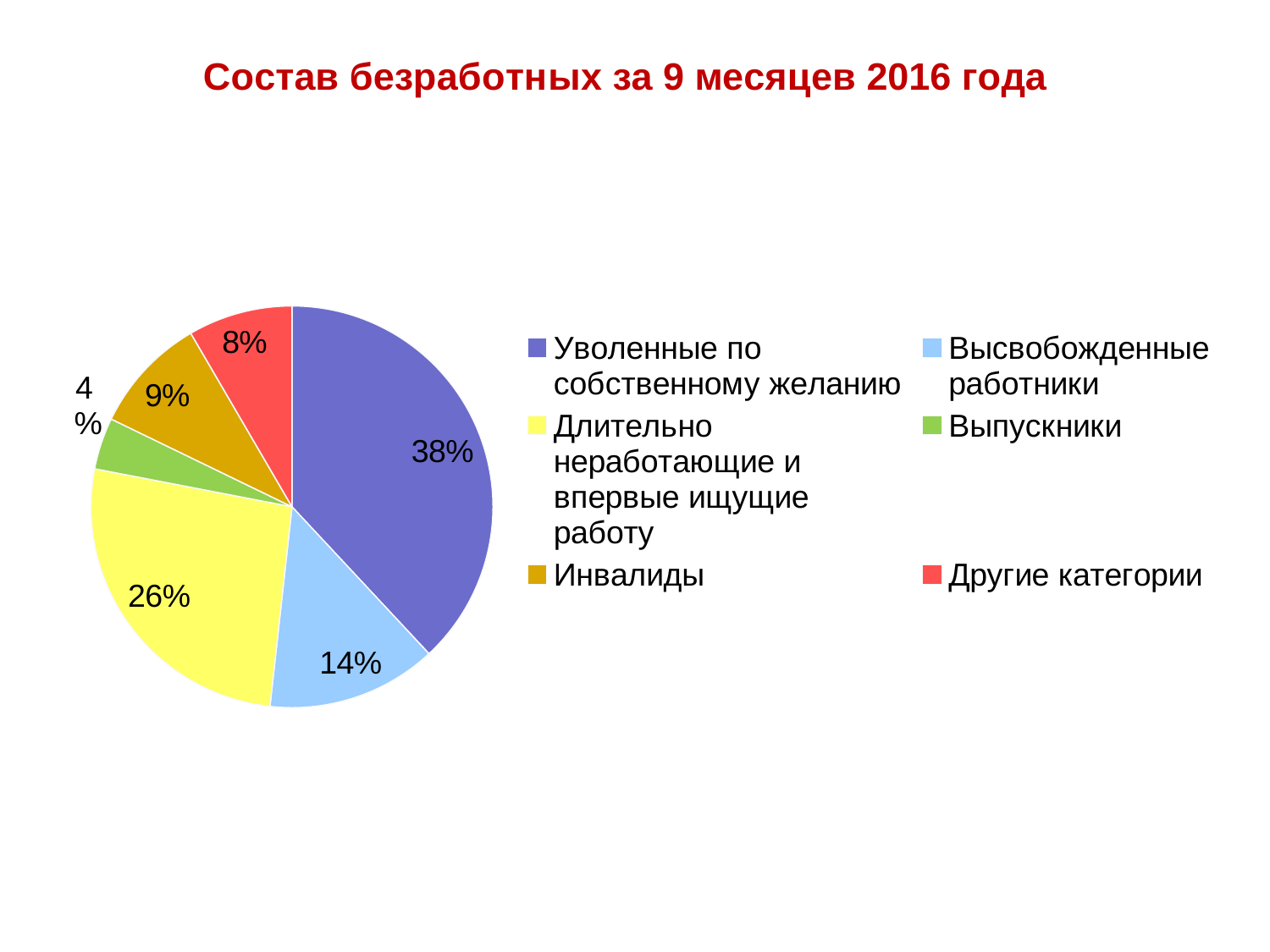
What share of the unemployed are 'Выпускники'? 4% What share of the unemployed are 'Высвобожденные работники'? 14% What share of the unemployed are 'Длительно неработающие и впервые ищущие работу'? 26% What kind of chart is shown on the slide? pie chart What is the difference in percentage points between 'Уволенные по собственному желанию' and 'Длительно неработающие и впервые ищущие работу'? 12 percentage points How many categories does the pie chart show? 6 Which is larger: the share for 'Инвалиды' or the share for 'Другие категории'? Инвалиды Which category has the largest share of the pie? Уволенные по собственному желанию Which category has the smallest share of the pie? Выпускники